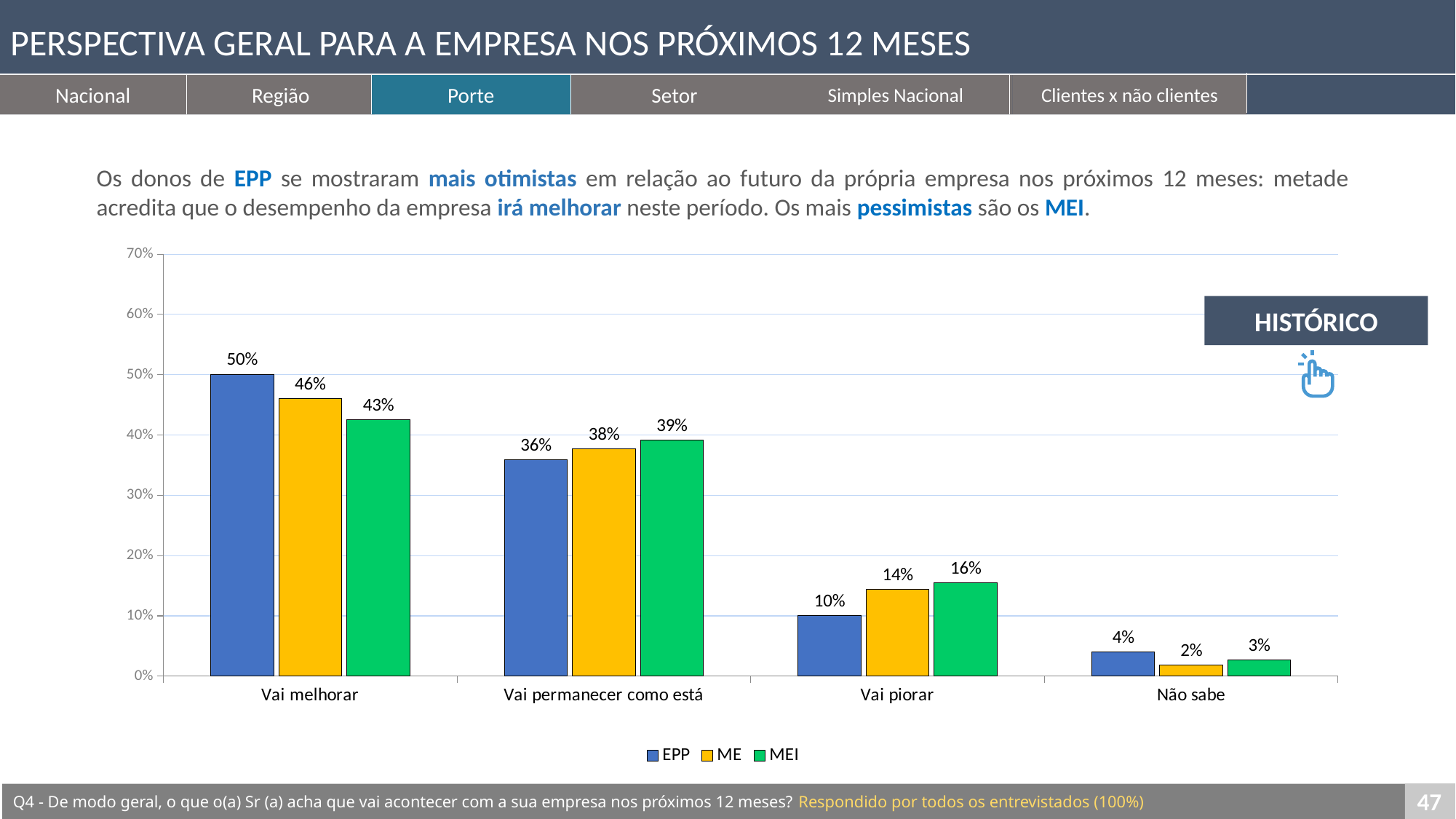
What is the value for MEI in the "Vai piorar" category? 16% What is the value for ME in the "Não sabe" category? 2% How many series does the legend list? 3 What colour are the ME bars? Yellow Is the value for MEI in "Vai permanecer como está" greater or less than 30%? greater Which series has the highest value in the "Vai permanecer como está" category? MEI How many categories are shown on the x axis? 4 Which is larger: the ME value for "Vai piorar" or the EPP value for "Vai piorar"? ME Which series has the lowest value in the "Vai melhorar" category? MEI What is the difference between the EPP and MEI values in the "Vai melhorar" category? 7% What kind of chart is shown on the slide? Bar chart What is the value for EPP in the "Vai melhorar" category? 50%